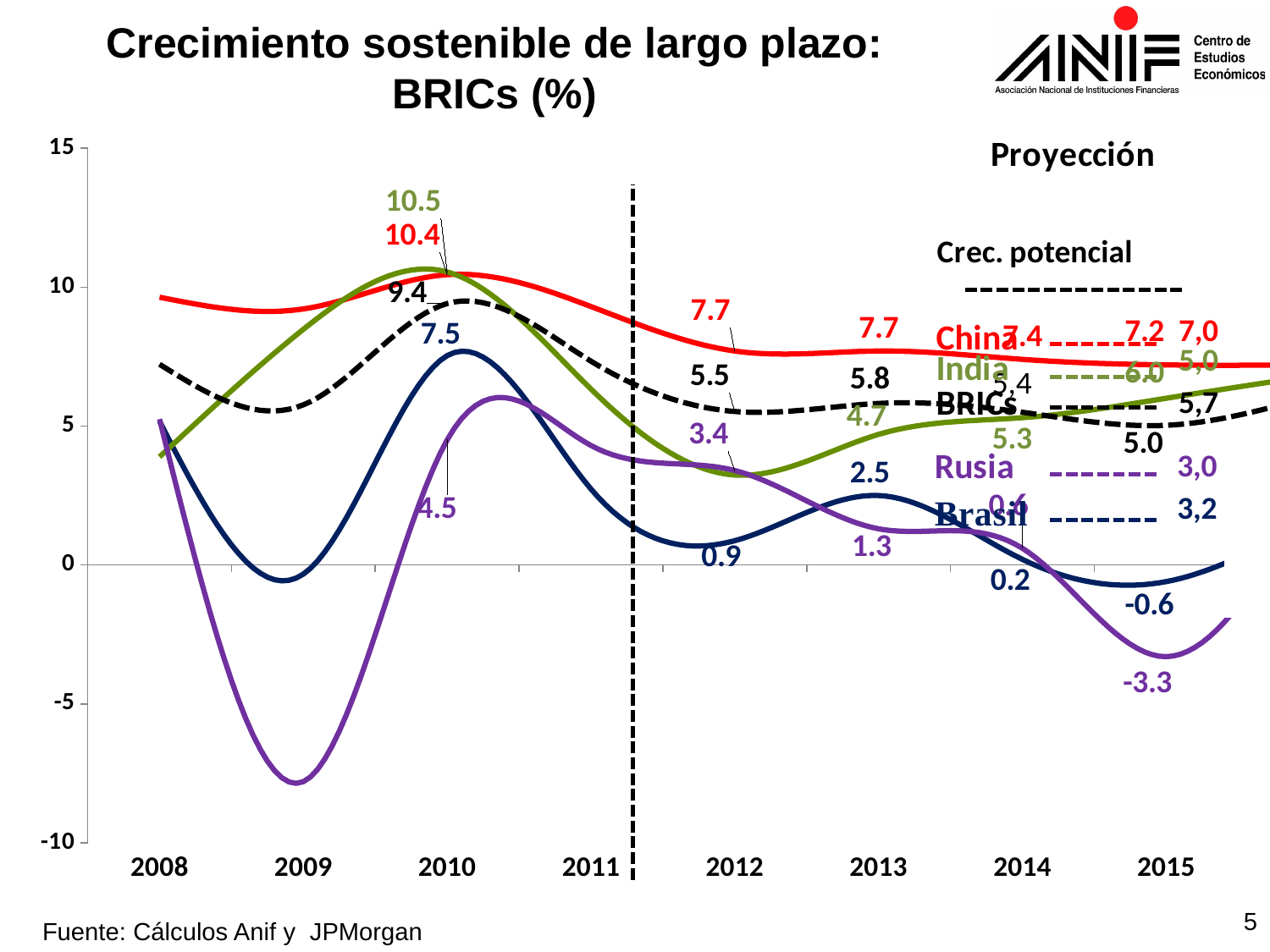
In 2013, which is larger: the value for BRICs or the value for India? BRICs What is the value for Rusia in 2015? -3.3 Is the value for Rusia in 2009 greater or less than -5? less What kind of chart is shown on the slide? line chart What is the value for China in 2010? 10.4 What is the value for India in 2010? 10.5 What is the difference between the values for China and Brasil in 2012? 6.8 How many years are shown on the x axis of the chart? 8 What is the 'Crec. potencial' value shown for China in the legend? 7,0 What is the value for BRICs in 2012? 5.5 Does the value for Brasil rise or fall from 2013 to 2015? fall Which series has the lowest value in 2015? Rusia